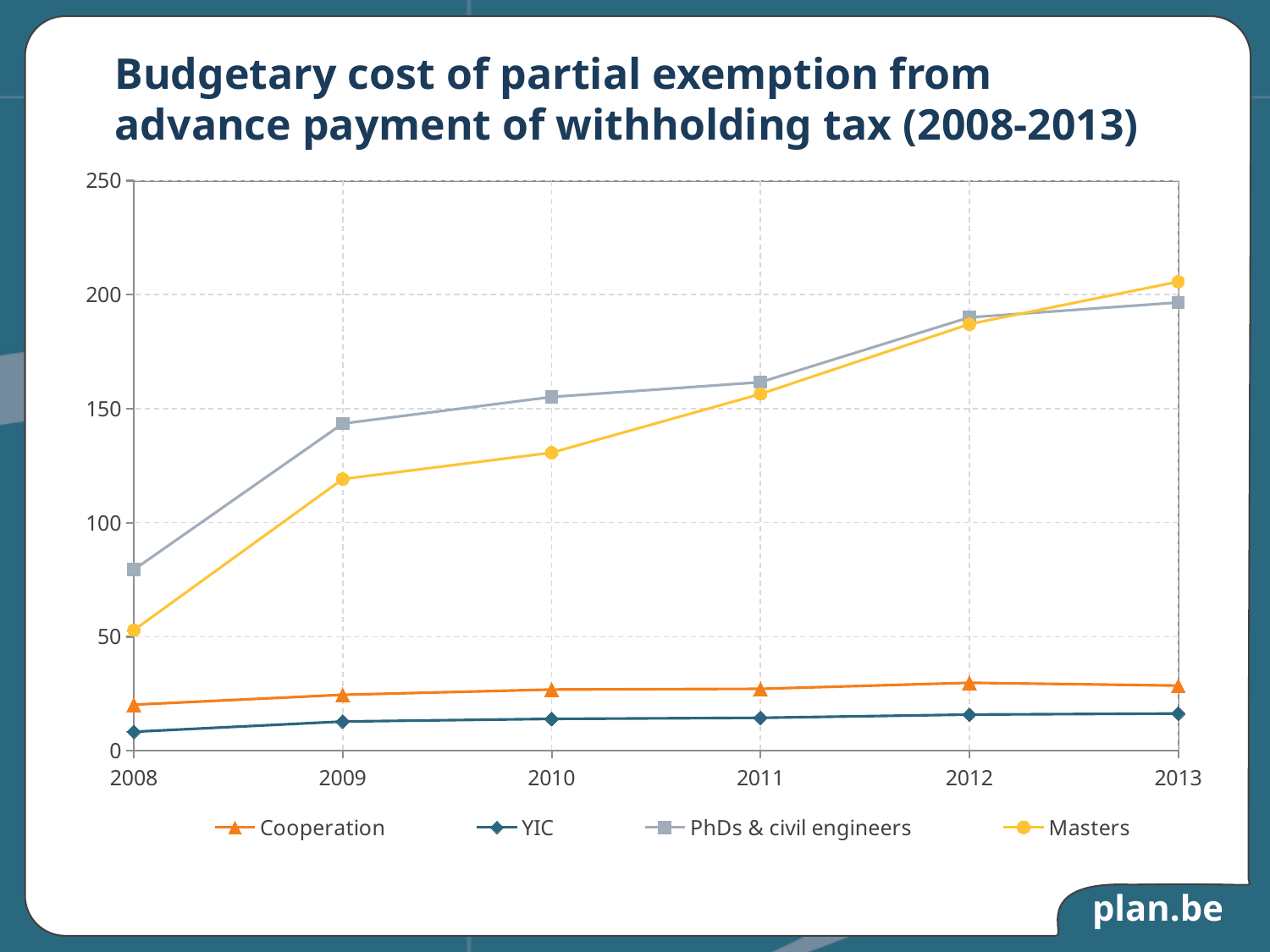
Is the value for Cooperation in 2012 greater or less than 50? less How many series does the legend list? 4 Does the Masters series rise or fall from 2008 to 2013? rise How many years are plotted along the x axis? 6 What kind of chart is shown on the slide? line chart Is the value for Masters in 2008 greater or less than 100? less What is the title of the chart? Budgetary cost of partial exemption from advance payment of withholding tax (2008-2013) Is the value for PhDs & civil engineers in 2009 greater or less than 150? less Which series has the lowest values across all years? YIC In 2008, which is larger: the value for PhDs & civil engineers or the value for Masters? PhDs & civil engineers In 2010, which is larger: the value for Cooperation or the value for YIC? Cooperation Which series has the highest value in 2013? Masters